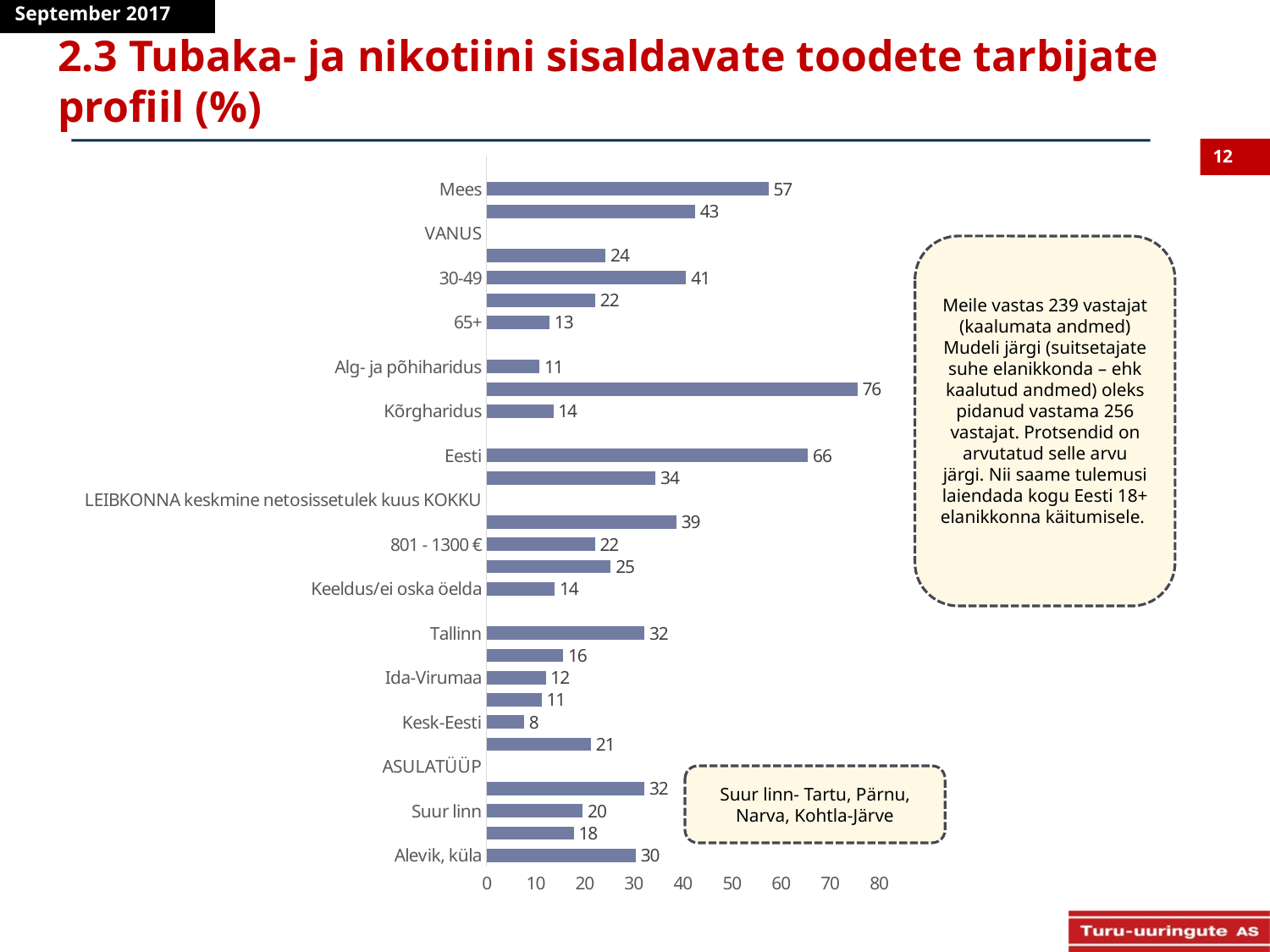
What kind of chart is shown on the slide? bar chart What is the value for Kesk-Eesti? 8 What is the value for 65+? 13 What is the value for Mees? 57 What is the value for Alevik, küla? 30 What is the value for Suur linn? 20 Which has the lowest value, Kesk-Eesti, Alg- ja põhiharidus or Kõrgharidus? Kesk-Eesti Is the value for Eesti greater or less than 60? greater What is the highest value shown on the x axis of the chart? 80 What is the value for Eesti? 66 What is the difference between the values for Mees and 30-49? 16 Which is larger, the value for Tallinn or the value for Ida-Virumaa? Tallinn